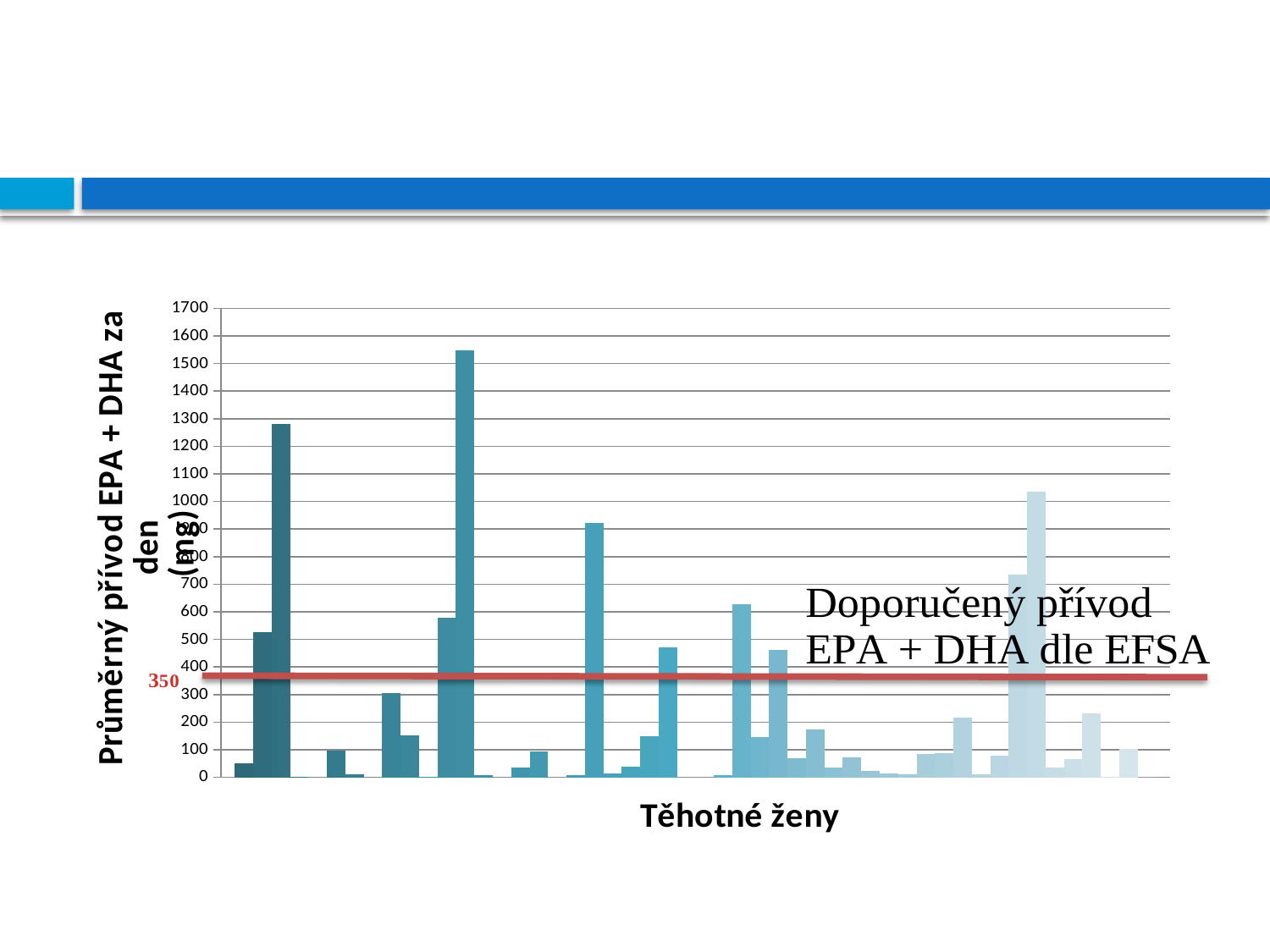
Is the red reference line on the chart above or below the 400 gridline? below What value is marked by the red horizontal line on the chart? 350 What kind of chart is shown on the slide? bar chart Is the value of the tallest bar on the chart greater or less than 1000? greater Is the value of the tallest bar on the chart greater or less than 1500? greater What is the title of the vertical axis of the chart? Průměrný přívod EPA + DHA za den (mg) What does the red horizontal line on the chart represent, according to its label? Doporučený přívod EPA + DHA dle EFSA